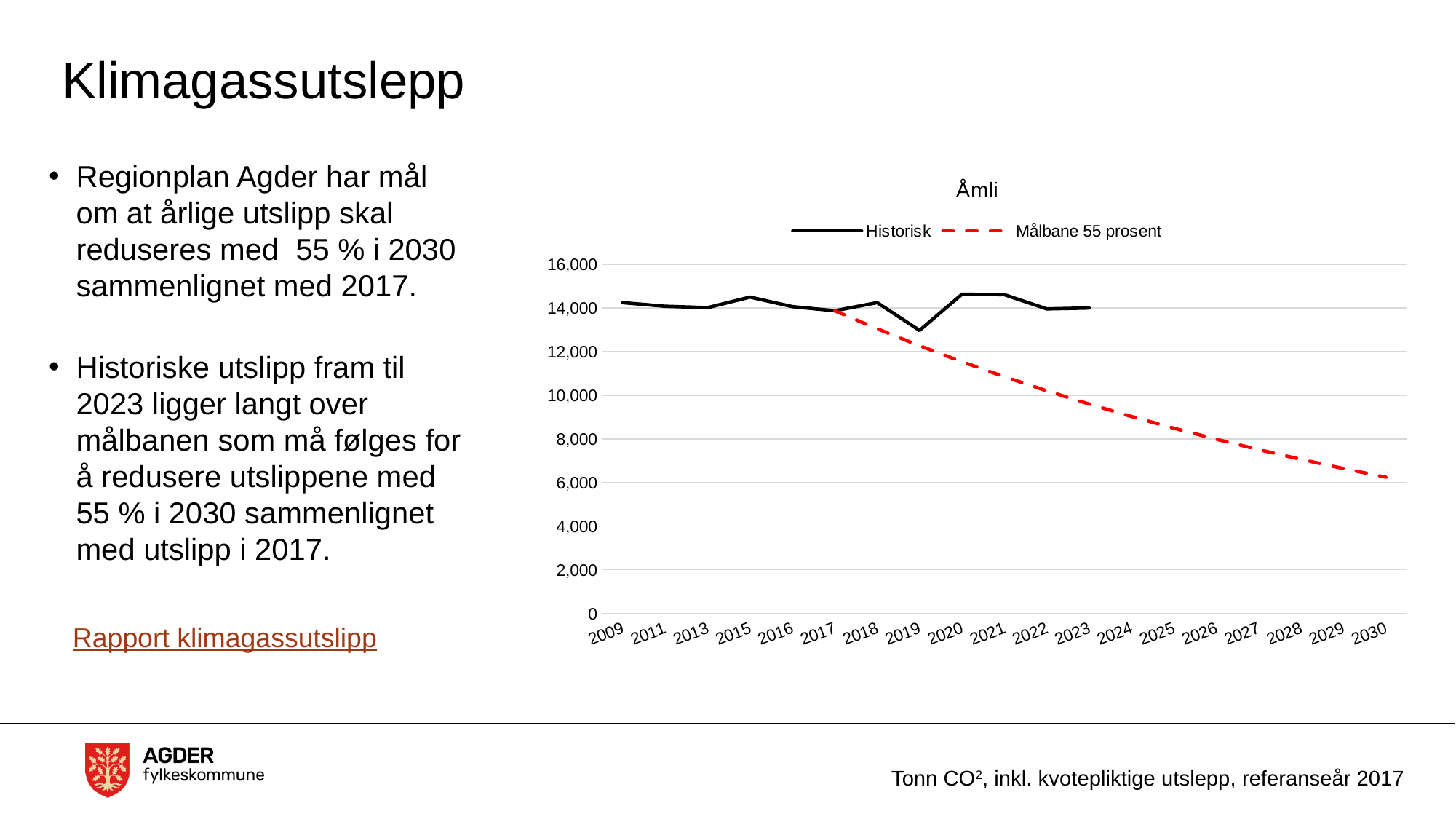
Does the Målbane 55 prosent series rise or fall from 2017 to 2030? fall In which year is the Historisk series at its lowest? 2019 Is the Historisk value for 2021 greater or less than 14,000? greater Is the Historisk value for 2019 greater or less than 14,000? less Is the Målbane 55 prosent value for 2024 greater or less than 12,000? less What are the names of the two series in the chart legend? Historisk and Målbane 55 prosent What kind of chart is shown on the slide? line chart How many years are labelled on the x axis of the chart? 19 What is the title of the chart? Åmli In 2023, which series has the higher value, Historisk or Målbane 55 prosent? Historisk How many series does the chart legend list? 2